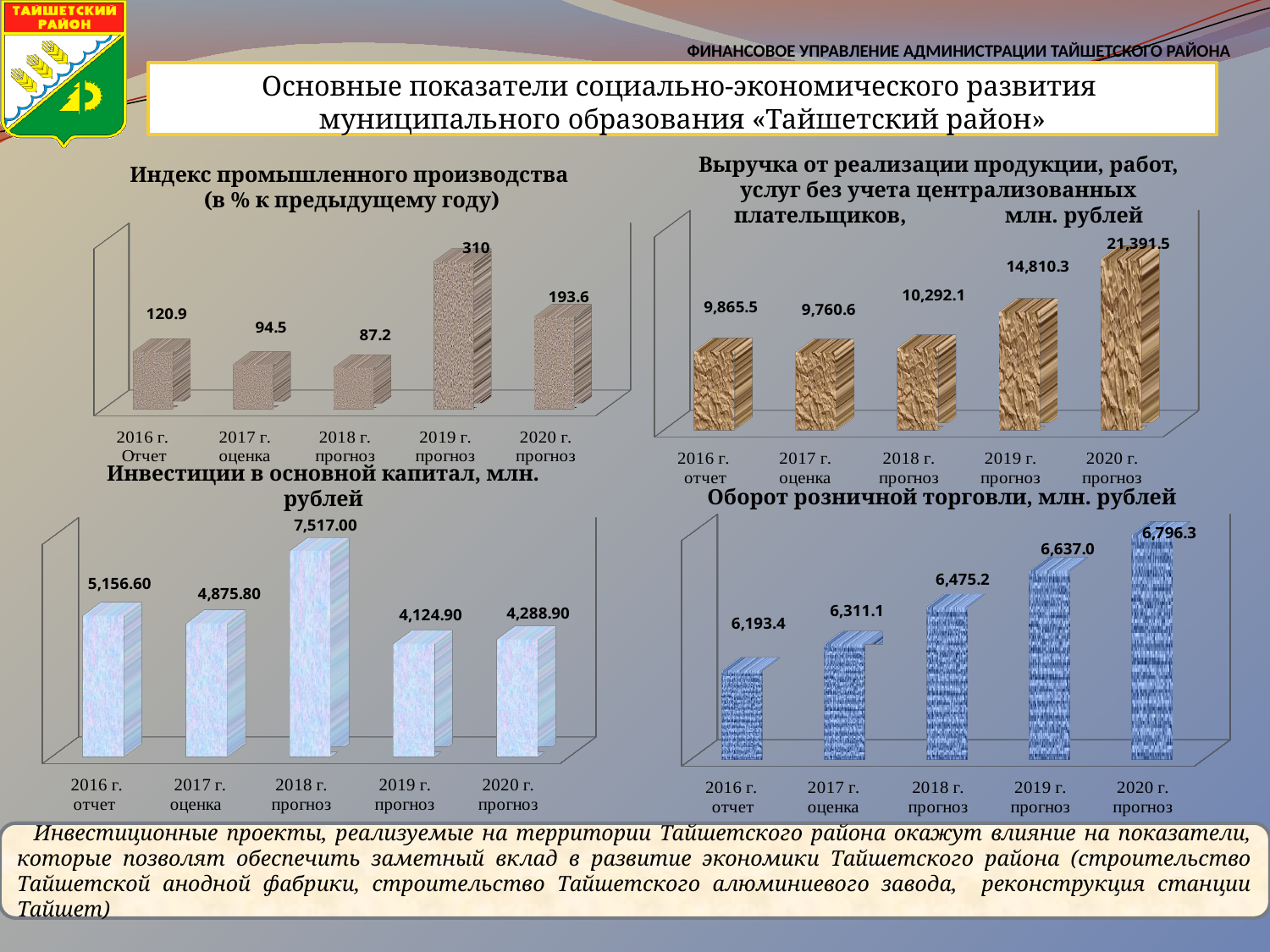
In the chart 'Индекс промышленного производства (в % к предыдущему году)', what is the value for 2019 г. прогноз? 310 In the chart 'Выручка от реализации продукции, работ, услуг без учета централизованных плательщиков, млн. рублей', what is the value for 2020 г. прогноз? 21,391.5 In the chart 'Инвестиции в основной капитал, млн. рублей', how many bars are plotted? 5 In the chart 'Оборот розничной торговли, млн. рублей', what is the value for 2016 г. отчет? 6,193.4 In the chart 'Инвестиции в основной капитал, млн. рублей', what is the value for 2018 г. прогноз? 7,517.00 What type of chart is 'Оборот розничной торговли, млн. рублей'? bar chart In the chart 'Инвестиции в основной капитал, млн. рублей', which year has the lowest value? 2019 г. прогноз In the chart 'Выручка от реализации продукции, работ, услуг без учета централизованных плательщиков, млн. рублей', which year has the highest value? 2020 г. прогноз In the chart 'Индекс промышленного производства (в % к предыдущему году)', which year has the lowest value? 2018 г. прогноз In the chart 'Индекс промышленного производства (в % к предыдущему году)', what is the difference between the 2016 г. отчет value and the 2017 г. оценка value? 26.4 In the chart 'Выручка от реализации продукции, работ, услуг без учета централизованных плательщиков, млн. рублей', which is larger: the value for 2016 г. отчет or 2017 г. оценка? 2016 г. отчет In the chart 'Оборот розничной торговли, млн. рублей', do the values rise or fall from 2016 to 2020? rise